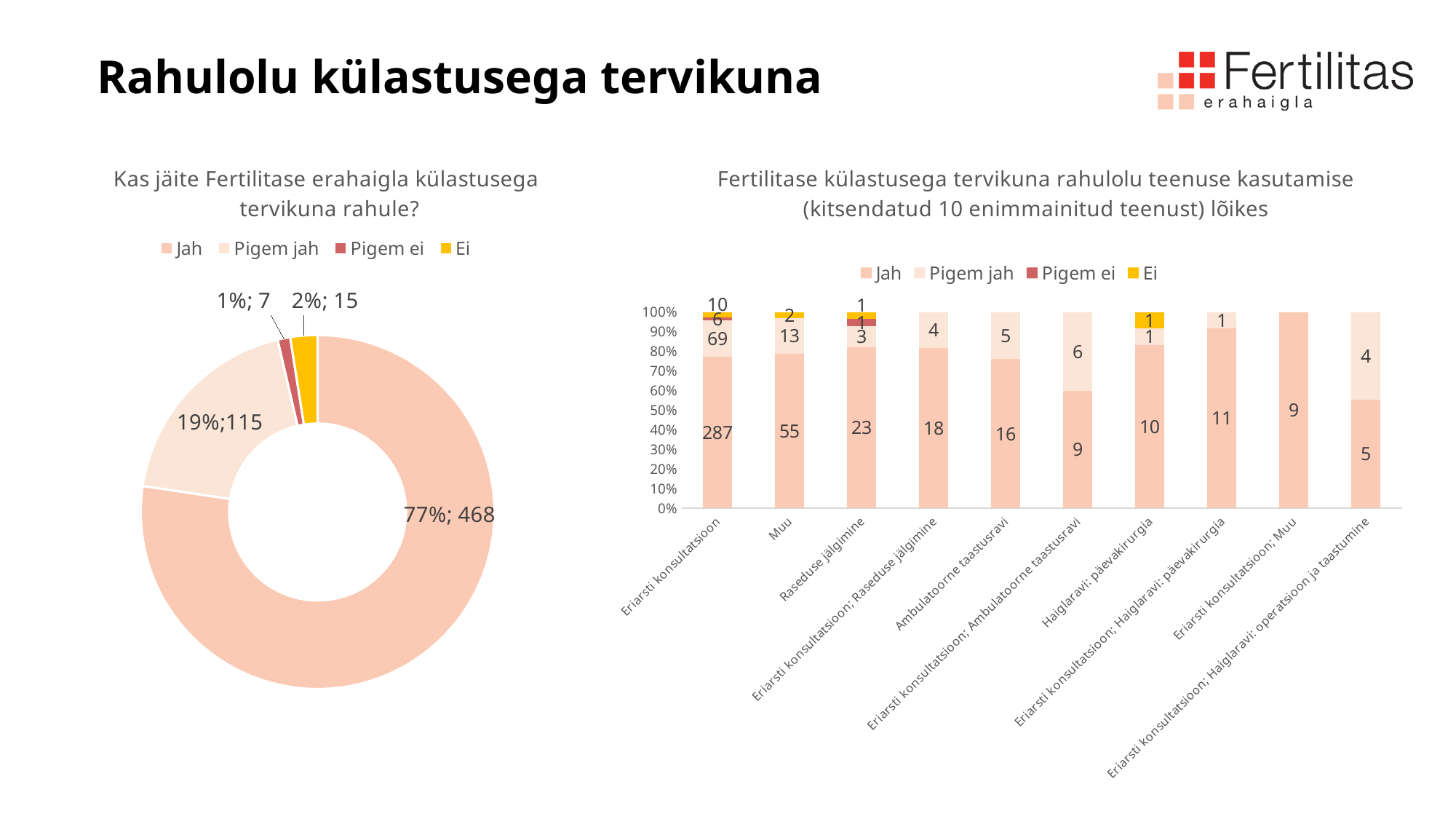
In the left donut chart, how many more responses are "Ei" than "Pigem ei"? 8 What type of chart is the chart on the left? Donut (pie) chart In the right stacked bar chart, is the "Jah" share for "Eriarsti konsultatsioon; Haiglaravi: operatsioon ja taastumine" greater or less than 70%? less How many series does the legend of the right stacked bar chart list? 4 In the left donut chart, what share of responses is "Pigem jah"? 19% In the right stacked bar chart, what is the "Jah" value for "Eriarsti konsultatsioon"? 287 In the left donut chart, what value is shown for the "Jah" slice? 77%; 468 In the left donut chart, which category has the smallest slice? Pigem ei In the right stacked bar chart, what is the total number of responses for "Raseduse jälgimine"? 28 In the right stacked bar chart, what is the "Pigem jah" value for "Muu"? 13 In the right stacked bar chart, which is larger: the "Jah" value for "Ambulatoorne taastusravi" or for "Eriarsti konsultatsioon; Ambulatoorne taastusravi"? Ambulatoorne taastusravi In the right stacked bar chart, how many categories are shown on the x axis? 10